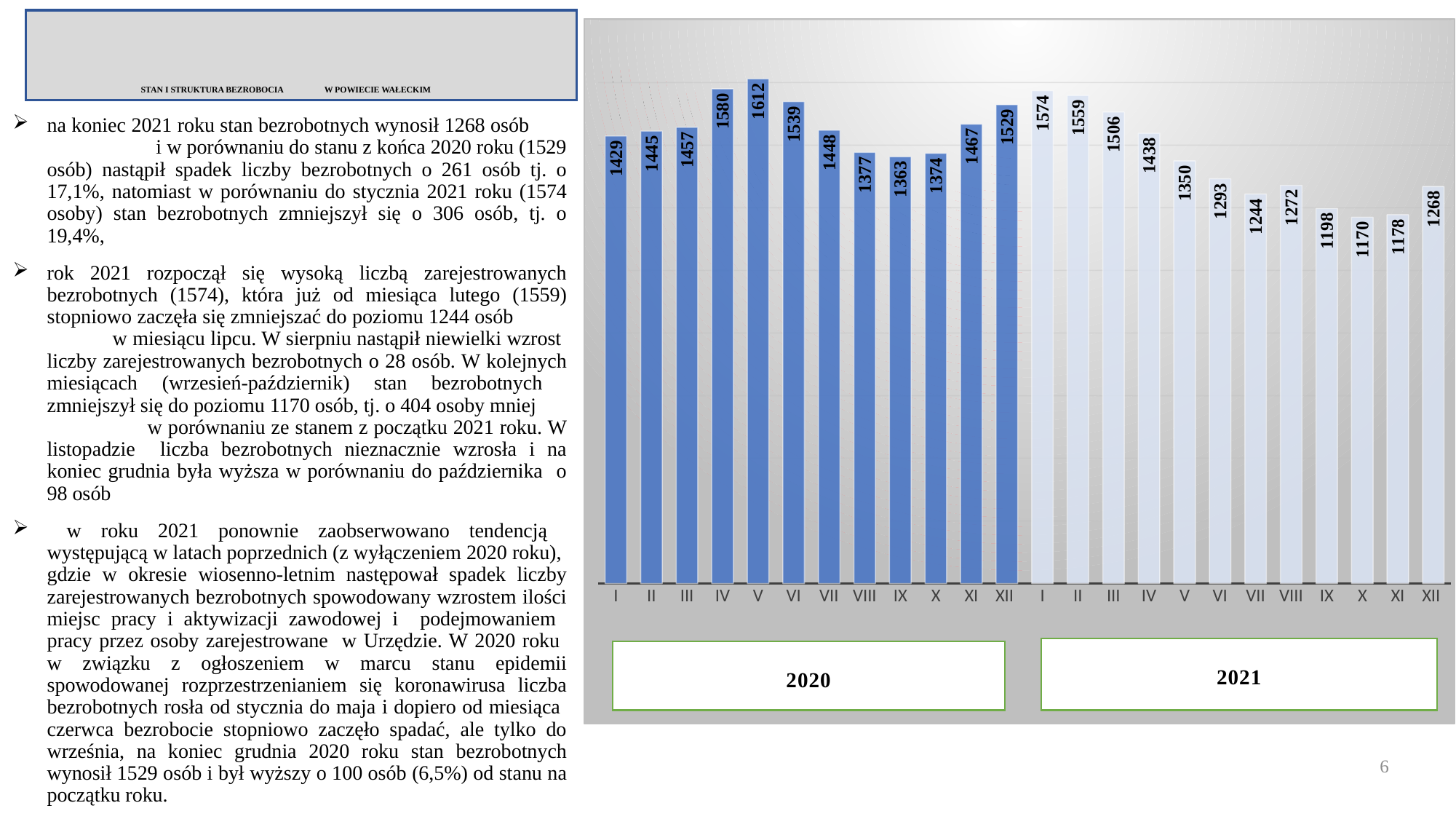
What is the difference between the values for month I of 2021 and month X of 2021? 404 What kind of chart is shown on the slide? bar chart What is the difference between the values for month XII of 2020 and month XII of 2021? 261 Which month of 2020 has the highest value? V Which is larger, the value for month VII of 2020 or the value for month VII of 2021? VII of 2020 Do the values generally rise or fall from month I to month VII of 2021? fall Which month of 2020 has the lowest value? IX How many bars are plotted in the chart in total? 24 What is the value for month V of 2020? 1612 Which month of 2021 has the lowest value? X What is the value for month XII of 2021? 1268 What is the value for month I of 2021? 1574